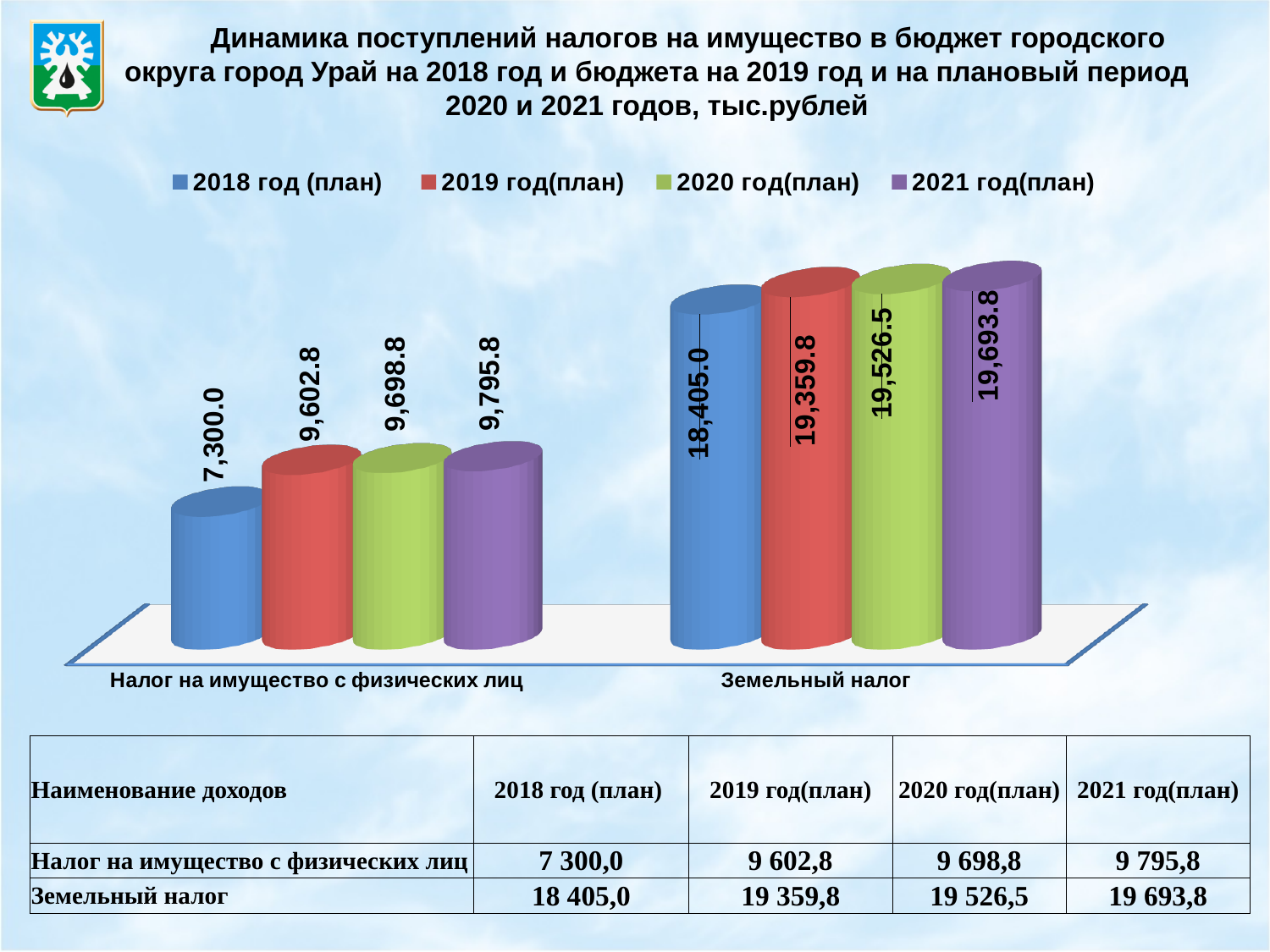
What is the difference between the 2019 год(план) and 2018 год (план) values for Налог на имущество с физических лиц? 2,302.8 What is the value for Земельный налог in the 2019 год(план) series? 19,359.8 What is the value for Налог на имущество с физических лиц in the 2021 год(план) series? 9,795.8 What kind of chart is shown on the slide? Bar chart Which series has the lowest value for Налог на имущество с физических лиц? 2018 год (план) What is the value for Налог на имущество с физических лиц in the 2018 год (план) series? 7,300.0 Which series has the highest value for Земельный налог? 2021 год(план) What is the value for Земельный налог in the 2020 год(план) series? 19,526.5 What is the difference between the 2021 год(план) and 2018 год (план) values for Земельный налог? 1,288.8 How many categories are shown on the x axis of the chart? 2 Which is larger: the 2018 год (план) value for Земельный налог or the 2021 год(план) value for Налог на имущество с физических лиц? 2018 год (план) value for Земельный налог How many series does the chart legend list? 4